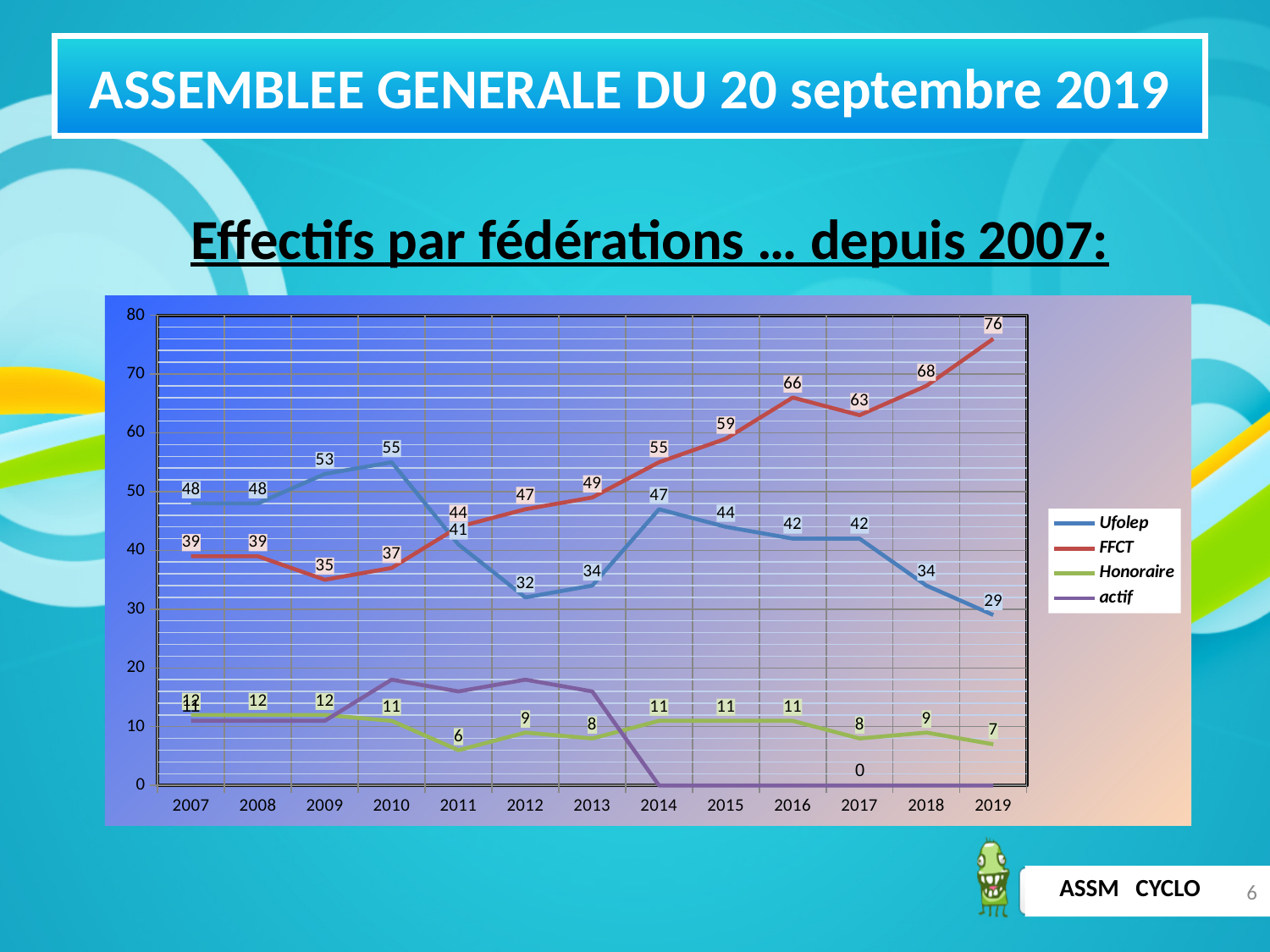
How many years are shown on the x axis? 13 How many series does the legend list? 4 Is the value of the actif series in 2012 greater or less than 10? greater In 2014, which series has the larger value, Ufolep or FFCT? FFCT Does the FFCT series overall rise or fall from 2007 to 2019? rise What is the Honoraire value in 2011? 6 What is the difference between the FFCT and Ufolep values in 2019? 47 What is the Ufolep value in 2010? 55 What is the FFCT value in 2019? 76 What kind of chart is shown on the slide? line chart In which year does the FFCT series reach its highest value? 2019 In which year is the Ufolep series at its lowest value? 2019